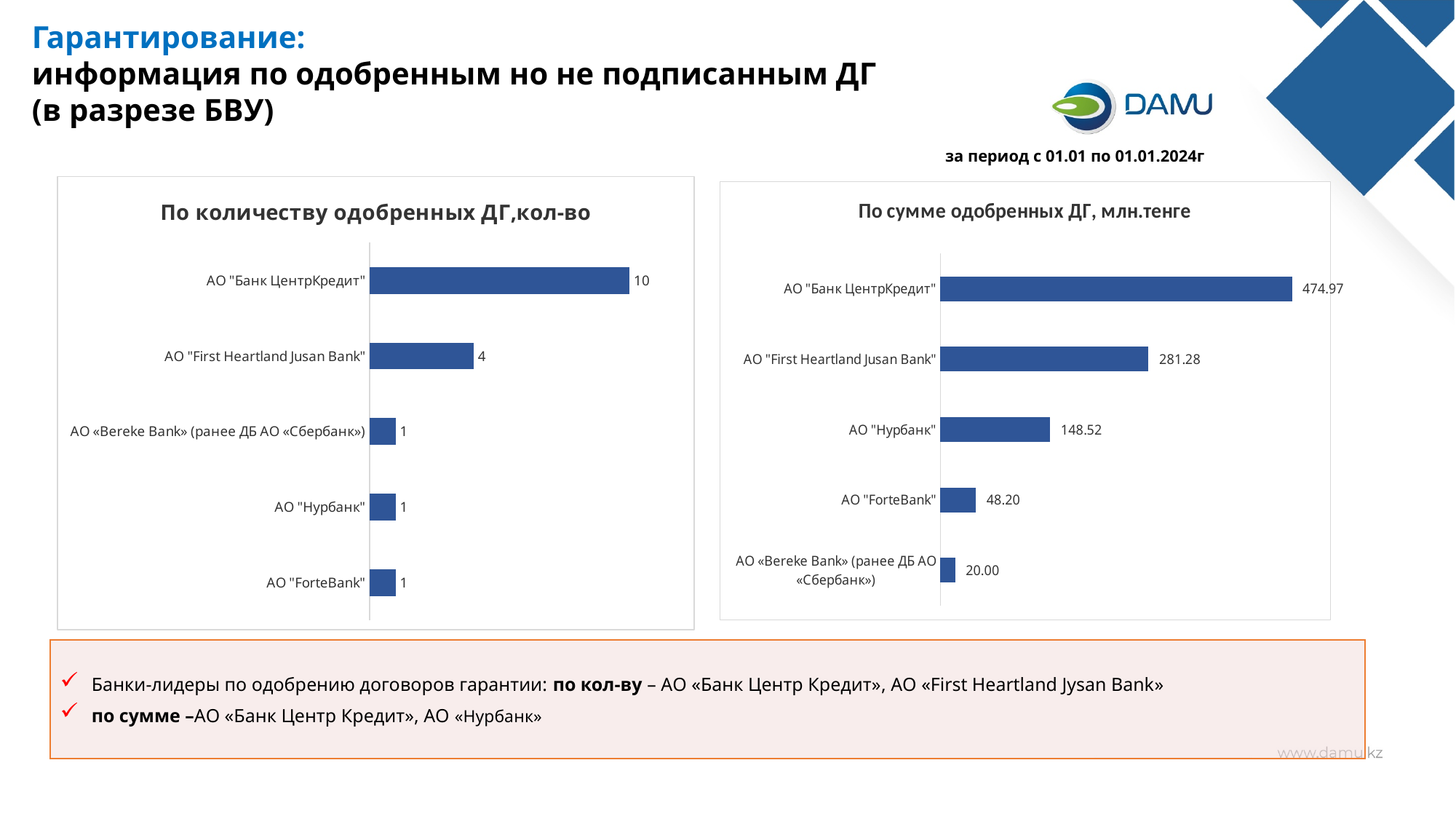
In the chart "По количеству одобренных ДГ,кол-во", what is the value for АО "First Heartland Jusan Bank"? 4 What type of chart is "По сумме одобренных ДГ, млн.тенге"? Bar chart What is the title of the chart on the left side of the slide? По количеству одобренных ДГ,кол-во In the chart "По сумме одобренных ДГ, млн.тенге", what is the difference between АО "Банк ЦентрКредит" and АО "First Heartland Jusan Bank"? 193.69 In the chart "По количеству одобренных ДГ,кол-во", which bank has the highest value? АО "Банк ЦентрКредит" In the chart "По сумме одобренных ДГ, млн.тенге", what is the value for АО "Нурбанк"? 148.52 In the chart "По сумме одобренных ДГ, млн.тенге", which is larger: the value for АО "Нурбанк" or АО "ForteBank"? АО "Нурбанк" In the chart "По сумме одобренных ДГ, млн.тенге", which bank has the lowest value? АО «Bereke Bank» (ранее ДБ АО «Сбербанк») In the chart "По сумме одобренных ДГ, млн.тенге", what is the value for АО "ForteBank"? 48.20 In the chart "По количеству одобренных ДГ,кол-во", what is the difference between АО "Банк ЦентрКредит" and АО "First Heartland Jusan Bank"? 6 In the chart "По количеству одобренных ДГ,кол-во", how many banks are shown? 5 In the chart "По количеству одобренных ДГ,кол-во", what is the value for АО "Банк ЦентрКредит"? 10